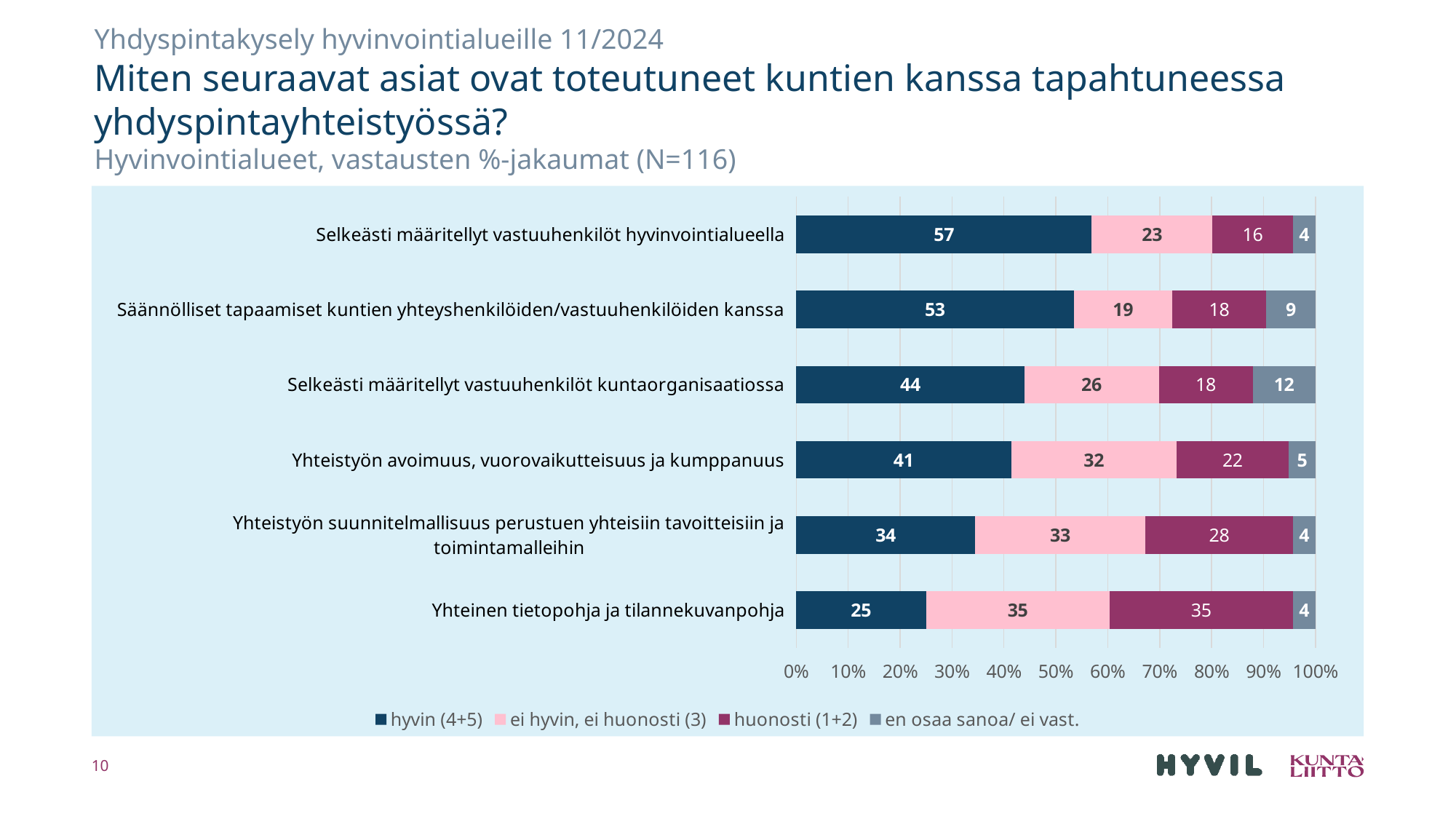
What is the difference between the "hyvin (4+5)" values for "Säännölliset tapaamiset kuntien yhteyshenkilöiden/vastuuhenkilöiden kanssa" and "Yhteistyön avoimuus, vuorovaikutteisuus ja kumppanuus"? 12 How many series does the legend list? 4 How many categories are shown in the chart? 6 What is the value of "huonosti (1+2)" for "Yhteinen tietopohja ja tilannekuvanpohja"? 35 What is the value of "en osaa sanoa/ ei vast." for "Selkeästi määritellyt vastuuhenkilöt kuntaorganisaatiossa"? 12 What is the total of the stacked bar for "Yhteistyön avoimuus, vuorovaikutteisuus ja kumppanuus"? 100 Which is larger: the "ei hyvin, ei huonosti (3)" value for "Yhteistyön suunnitelmallisuus perustuen yhteisiin tavoitteisiin ja toimintamalleihin" or for "Selkeästi määritellyt vastuuhenkilöt kuntaorganisaatiossa"? Yhteistyön suunnitelmallisuus perustuen yhteisiin tavoitteisiin ja toimintamalleihin What is the sample size (N) stated in the chart subtitle? N=116 Which category has the lowest value for "hyvin (4+5)"? Yhteinen tietopohja ja tilannekuvanpohja Which category has the highest value for "hyvin (4+5)"? Selkeästi määritellyt vastuuhenkilöt hyvinvointialueella What is the value of "hyvin (4+5)" for "Selkeästi määritellyt vastuuhenkilöt hyvinvointialueella"? 57 What kind of chart is shown on the slide? Stacked bar chart